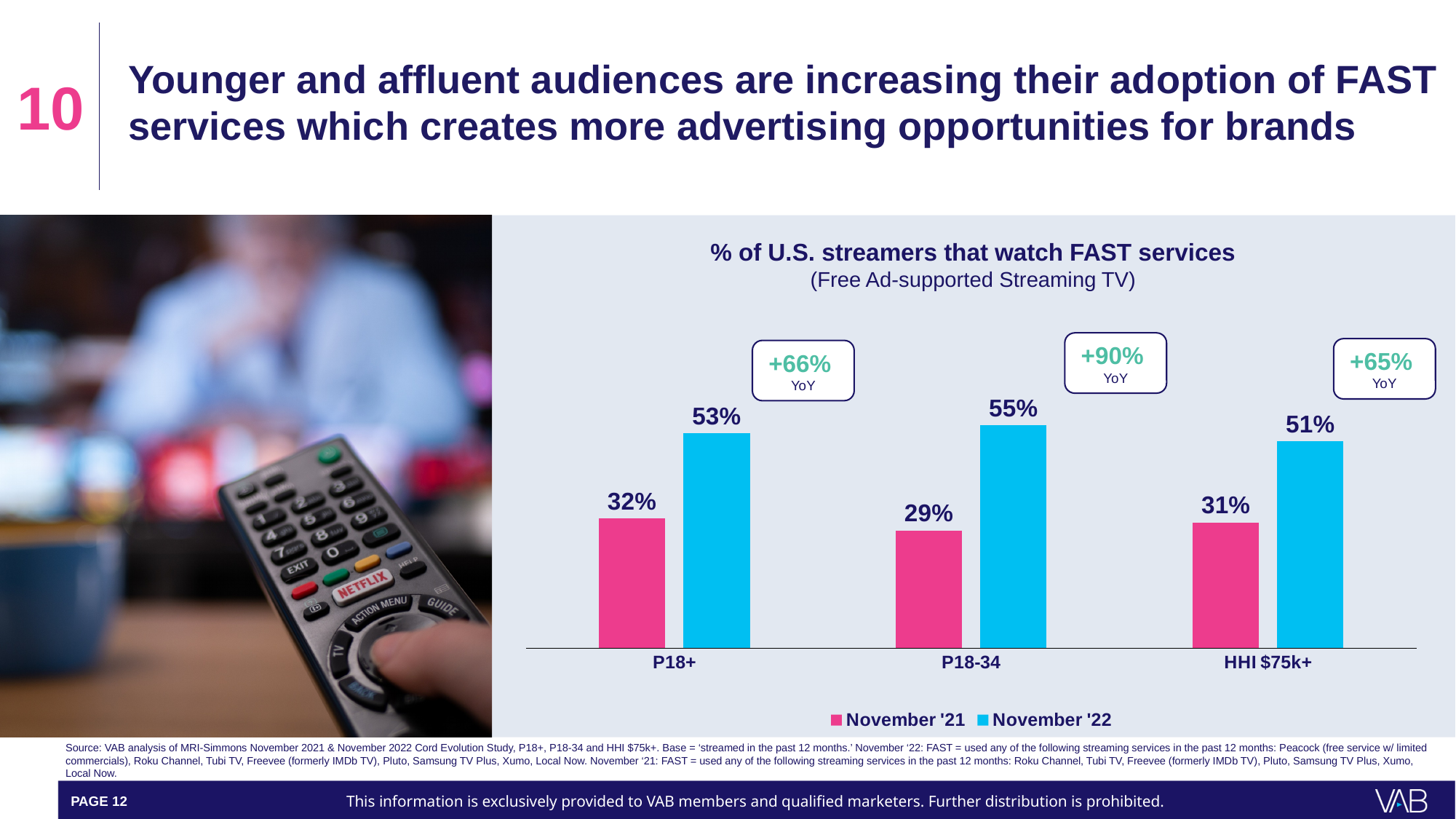
What is the November '22 value for P18-34? 55% Which category has the lowest November '21 value? P18-34 Which is larger for HHI $75k+: the November '21 value or the November '22 value? November '22 What YoY change is shown for P18-34? +90% What is the November '21 value for HHI $75k+? 31% How many categories are shown on the x axis? 3 What is the title of the chart? % of U.S. streamers that watch FAST services What kind of chart is shown on the slide? Bar chart How many series does the legend list? 2 What is the difference between the November '22 and November '21 values for P18+? 21% What is the November '21 value for P18+? 32% Which category has the highest November '22 value? P18-34